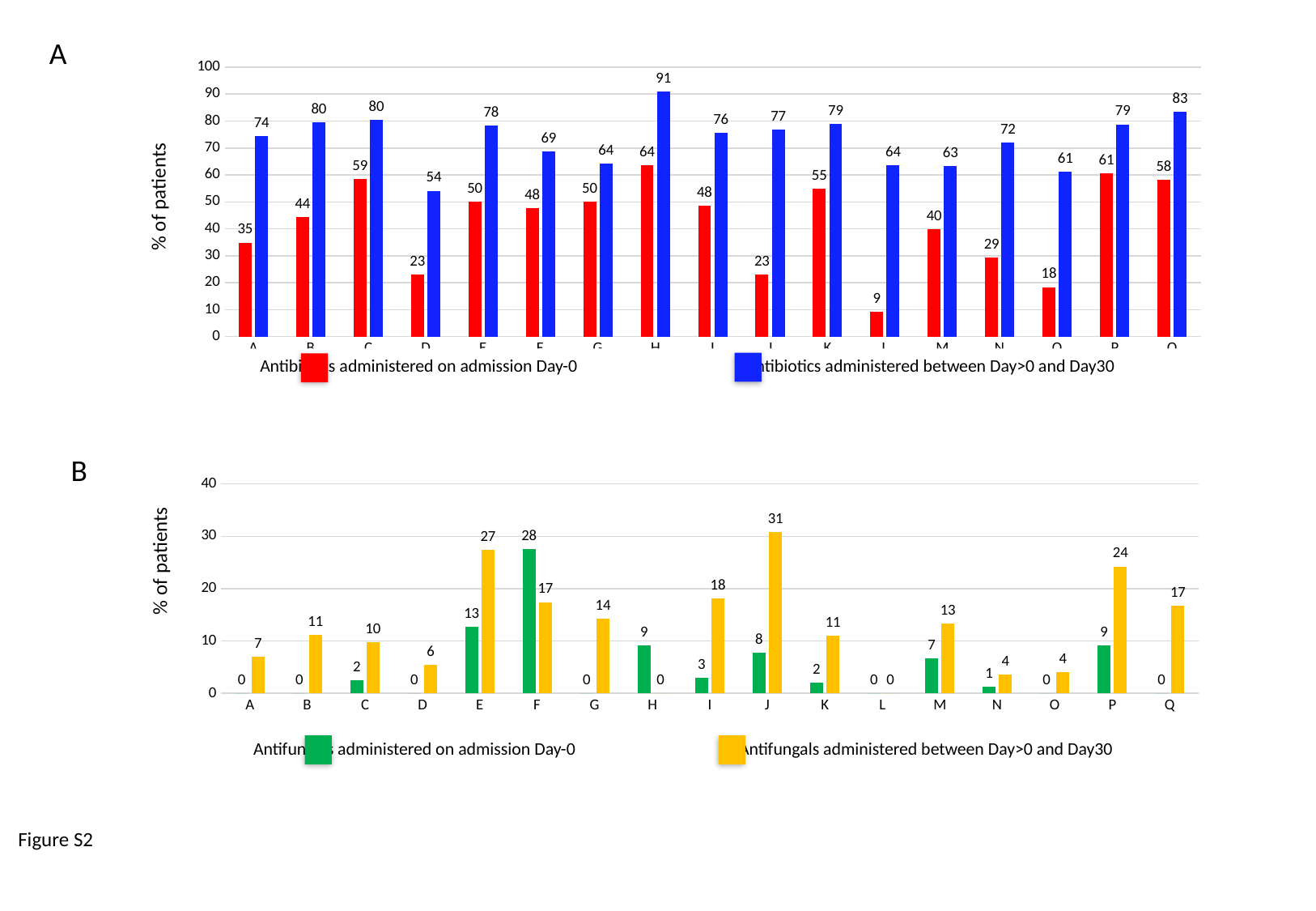
How many series does the legend of chart A (top) list? 2 In chart B (bottom), what is the difference between the two values shown for category E? 14 In chart A (top), which category has the highest value for antibiotics administered between Day>0 and Day30? H How many categories are shown on the x axis of chart B (bottom)? 17 In chart A (top), what is the value for antibiotics administered on admission Day-0 for category L? 9 In chart B (bottom), which category has the highest value for antifungals administered on admission Day-0? F In chart A (top), is the Day-0 antibiotics value for category P larger or smaller than that for category M? larger In chart A (top), what is the difference between the Day>0 to Day30 value and the Day-0 value for category D? 31 In chart B (bottom), what is the value for antifungals administered between Day>0 and Day30 for category J? 31 In chart A (top), which category has the lowest value for antibiotics administered on admission Day-0? L What type of chart is chart B (bottom)? bar chart In chart A (top), what percentage of patients in category H received antibiotics between Day>0 and Day30? 91